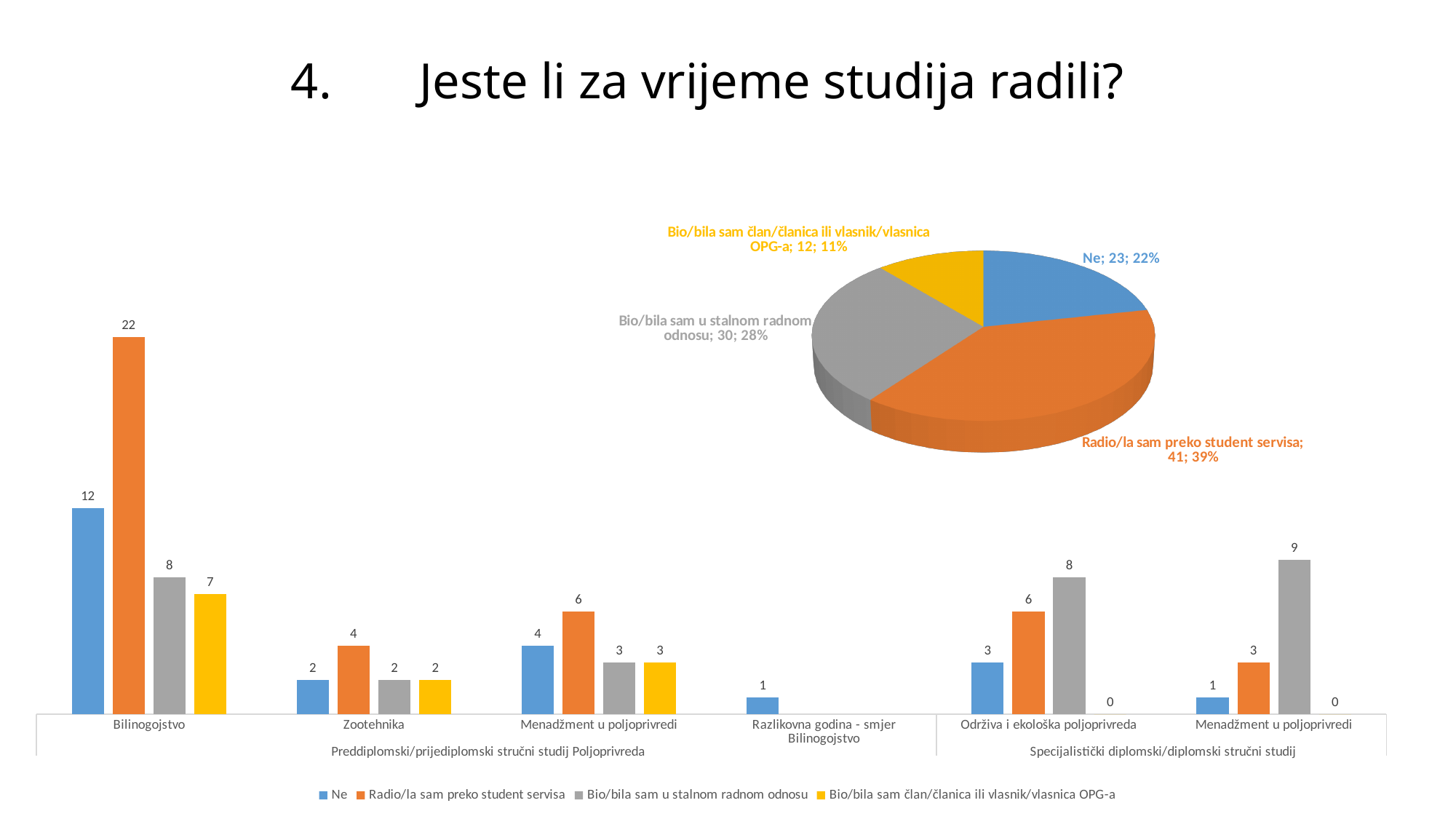
In the pie chart, what share does the "Ne" slice have? 22% In the pie chart, which category has the smallest slice? Bio/bila sam član/članica ili vlasnik/vlasnica OPG-a In the bar chart, what is the value of "Bio/bila sam u stalnom radnom odnosu" for Menadžment u poljoprivredi under Specijalistički diplomski/diplomski stručni studij? 9 In the bar chart, which category has the highest "Ne" value? Bilinogojstvo In the bar chart, for Održiva i ekološka poljoprivreda, which is larger: "Radio/la sam preko student servisa" or "Bio/bila sam u stalnom radnom odnosu"? Bio/bila sam u stalnom radnom odnosu In the bar chart, what is the difference between the "Ne" and "Radio/la sam preko student servisa" values for Bilinogojstvo? 10 In the bar chart, what is the value of "Bio/bila sam član/članica ili vlasnik/vlasnica OPG-a" for Zootehnika? 2 In the pie chart, how many slices are there? 4 In the pie chart, what value is shown for "Radio/la sam preko student servisa"? 41; 39% What type of chart is shown at the bottom of the slide? Bar chart In the bar chart, what is the value of "Radio/la sam preko student servisa" for Bilinogojstvo? 22 How many series does the bar chart's legend list? 4